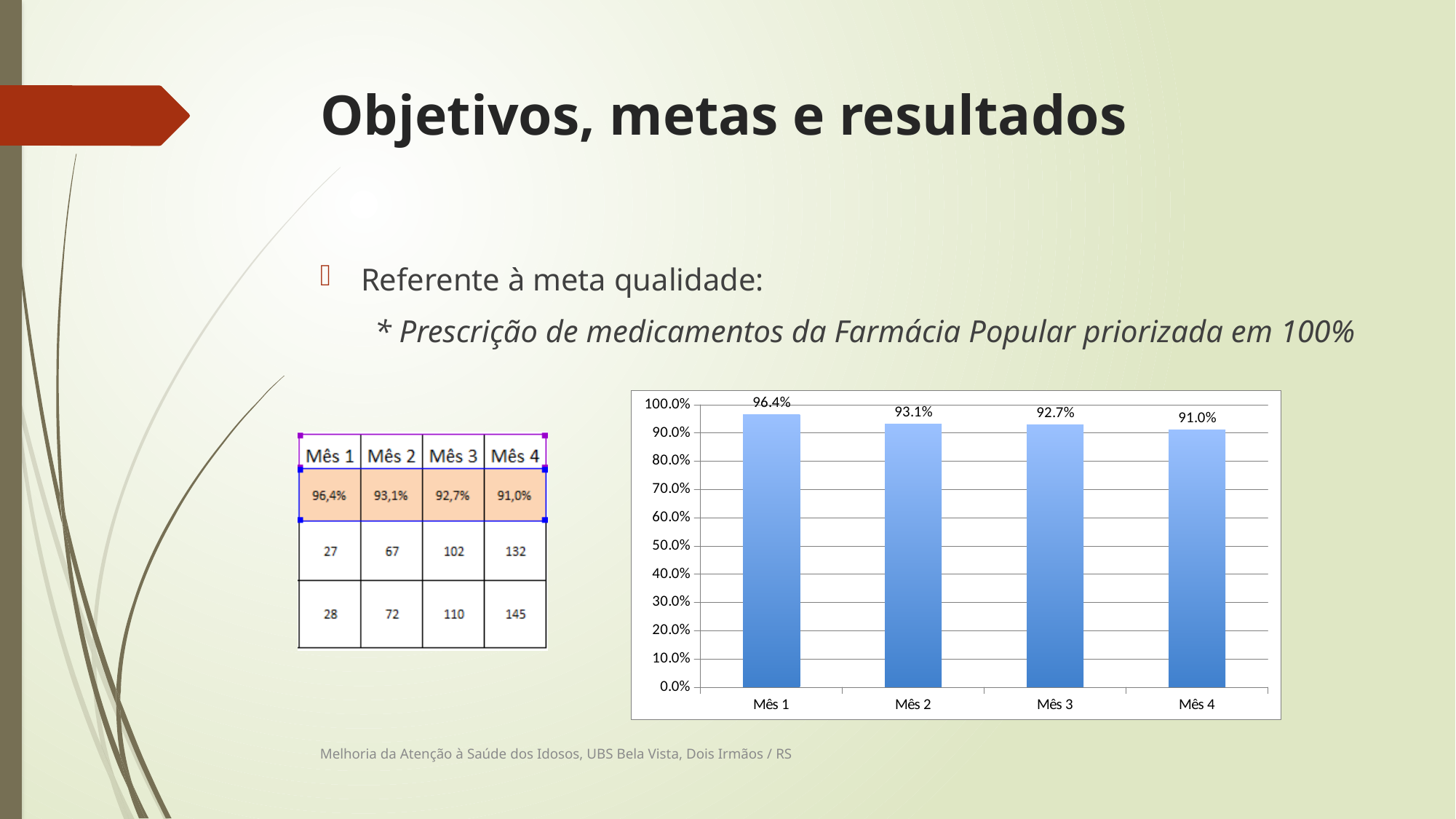
What kind of chart is shown on the slide? bar chart How many months are shown on the x axis of the bar chart? 4 What is the difference between the values for Mês 1 and Mês 4 in the bar chart? 5.4% What is the value for Mês 2 in the bar chart? 93.1% What is the value for Mês 1 in the bar chart? 96.4% What is the value for Mês 4 in the bar chart? 91.0% Do the values in the bar chart rise or fall from Mês 1 to Mês 4? fall Is the value for Mês 4 in the bar chart greater or less than 90.0%? greater What is the value for Mês 3 in the bar chart? 92.7% Which is larger in the bar chart, the value for Mês 2 or the value for Mês 4? Mês 2 Which month has the lowest value in the bar chart? Mês 4 Which month has the highest value in the bar chart? Mês 1